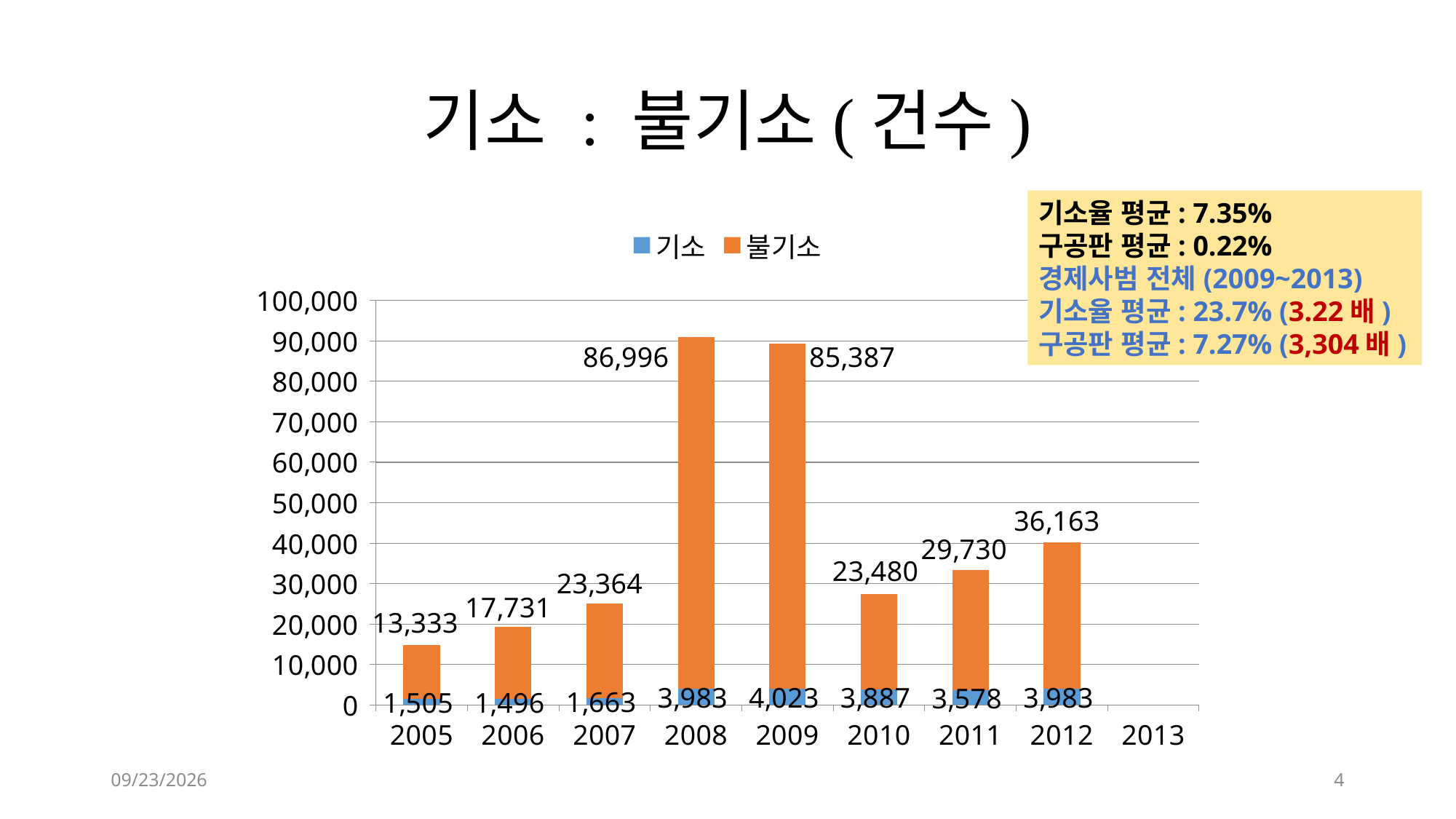
What colour represents the 불기소 series in the chart? Orange Which year has the highest 불기소 value? 2008 What is the value of 기소 for 2009? 4,023 What is the difference between the 불기소 values for 2008 and 2009? 1,609 How many series does the legend list? 2 Do the 불기소 values rise or fall from 2010 to 2012? Rise Which is larger, the 불기소 value for 2011 or for 2010? 2011 What is the value of 불기소 for 2008? 86,996 Which year has the lowest 기소 value? 2006 What is the total of the stacked bar for 2012 (기소 plus 불기소)? 40,146 What is the value of 불기소 for 2012? 36,163 What kind of chart is shown on the slide? Stacked bar chart